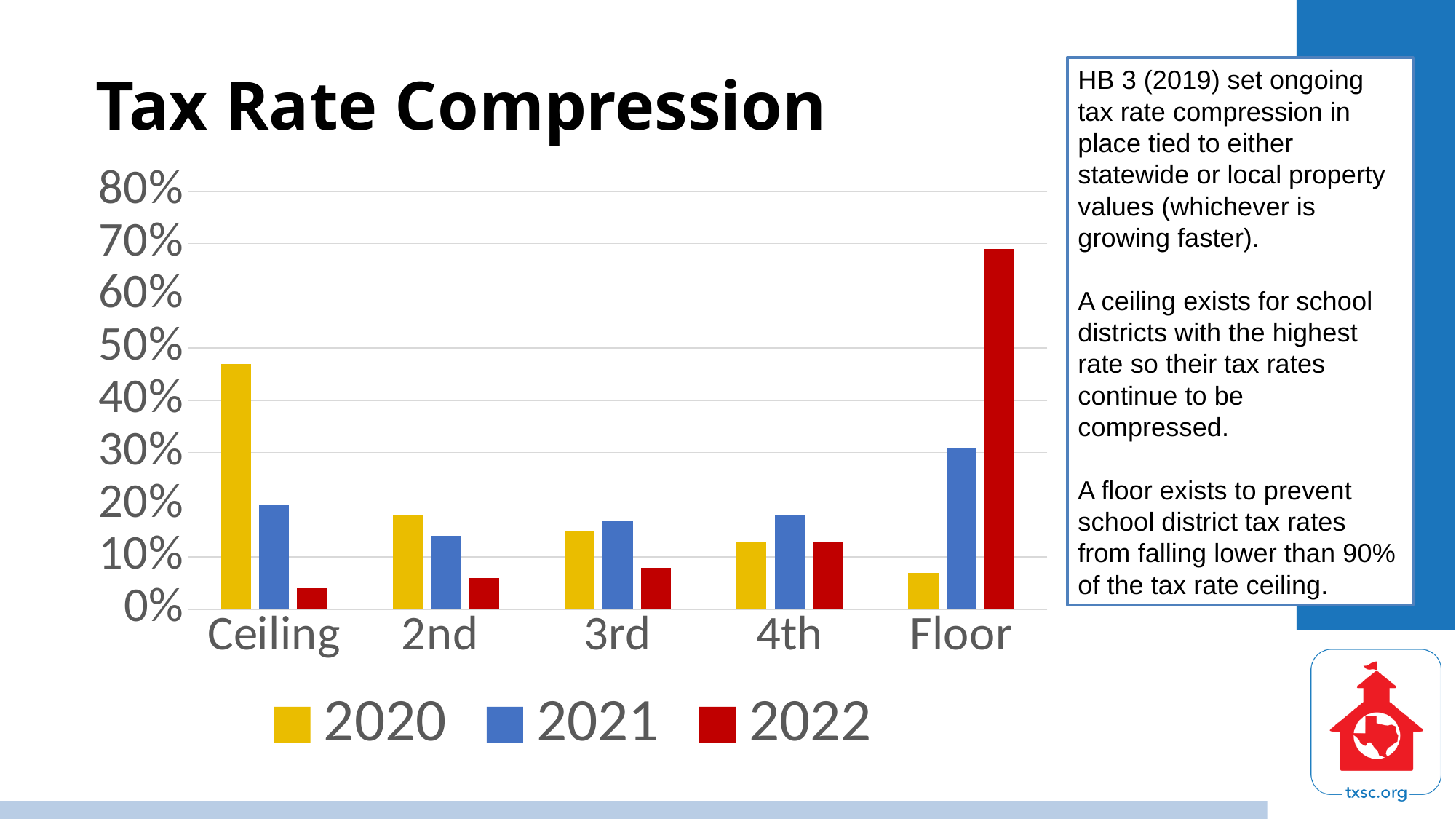
Which category has the lowest value for the 2022 series? Ceiling Is the 2021 value for Floor greater or less than 40%? less Do the values for the 2022 series rise or fall moving from Ceiling to Floor along the x axis? rise How many categories are shown on the x axis? 5 For the Ceiling category, which series has the larger value, 2020 or 2021? 2020 What is the title of the chart? Tax Rate Compression Which category has the highest value for the 2020 series? Ceiling Which category has the highest value for the 2022 series? Floor Is the 2020 value for Ceiling greater or less than 40%? greater Is the 2022 value for Floor greater or less than 60%? greater What kind of chart is shown on the slide? bar chart How many series does the legend list? 3